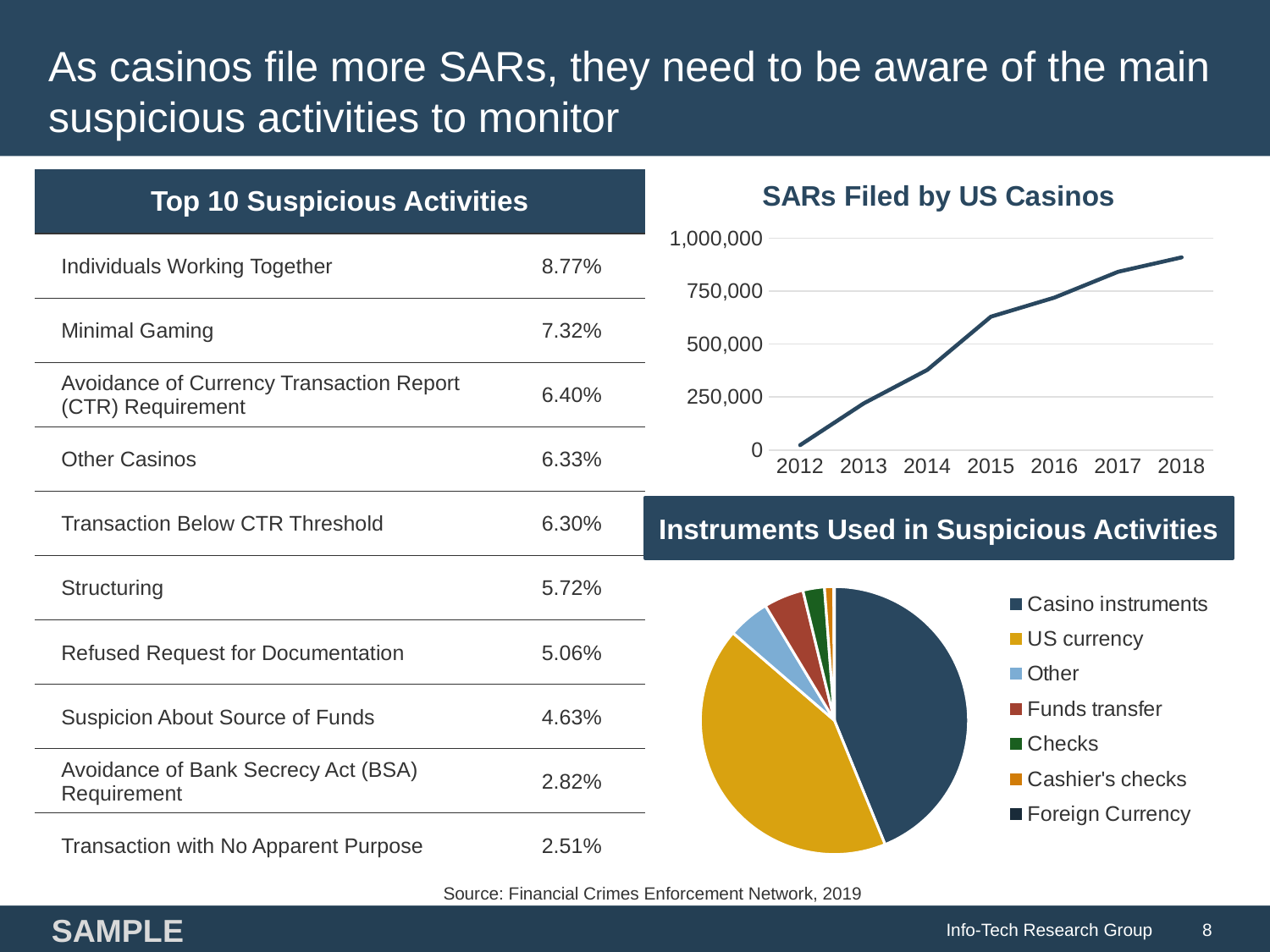
In the 'SARs Filed by US Casinos' chart, which year has the lowest value? 2012 In the 'SARs Filed by US Casinos' chart, is the value for 2017 greater or less than 750,000? greater In the 'SARs Filed by US Casinos' chart, do the values rise or fall from 2012 to 2018? rise In the 'SARs Filed by US Casinos' chart, which year has the highest value? 2018 In the 'SARs Filed by US Casinos' chart, is the value for 2014 greater or less than 500,000? less What kind of chart is the 'SARs Filed by US Casinos' chart? line chart What kind of chart is the 'Instruments Used in Suspicious Activities' chart? pie chart In the 'SARs Filed by US Casinos' chart, is the value for 2015 greater or less than 500,000? greater How many categories does the legend of the 'Instruments Used in Suspicious Activities' chart list? 7 How many years are plotted on the x axis of the 'SARs Filed by US Casinos' chart? 7